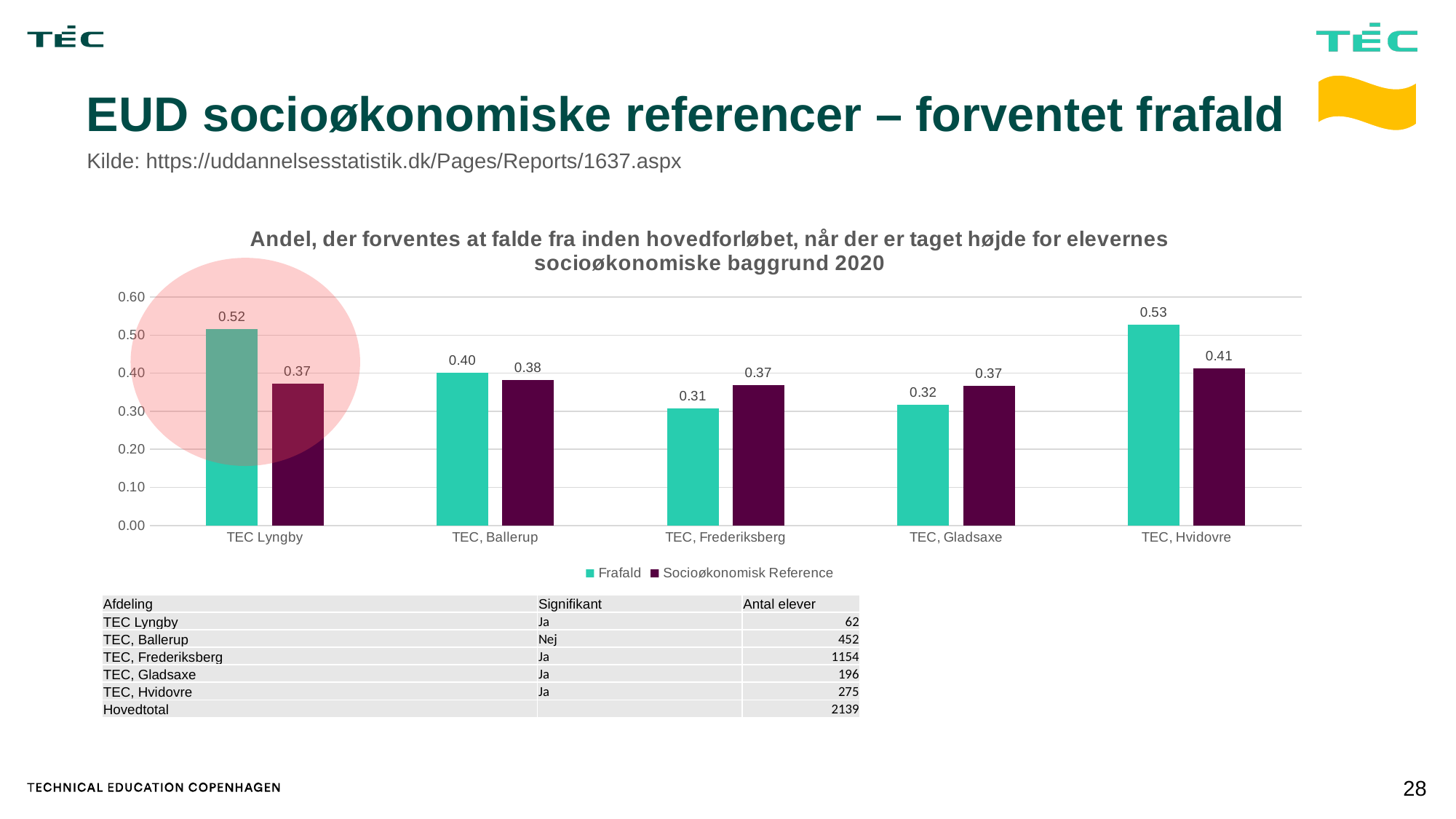
Which is larger for TEC, Gladsaxe: the Frafald value or the Socioøkonomisk Reference value? Socioøkonomisk Reference Which category has the highest Socioøkonomisk Reference value? TEC, Hvidovre What is the Frafald value for TEC, Frederiksberg? 0.31 What is the Frafald value for TEC Lyngby? 0.52 Which category has the highest Frafald value? TEC, Hvidovre What is the Socioøkonomisk Reference value for TEC, Ballerup? 0.38 How many series does the chart legend list? 2 How many categories are shown on the x axis of the chart? 5 What is the Socioøkonomisk Reference value for TEC, Hvidovre? 0.41 What is the difference between the Frafald and Socioøkonomisk Reference values for TEC Lyngby? 0.15 What kind of chart is shown on the slide? Bar chart Is the Frafald value for TEC, Hvidovre greater or less than 0.50? greater